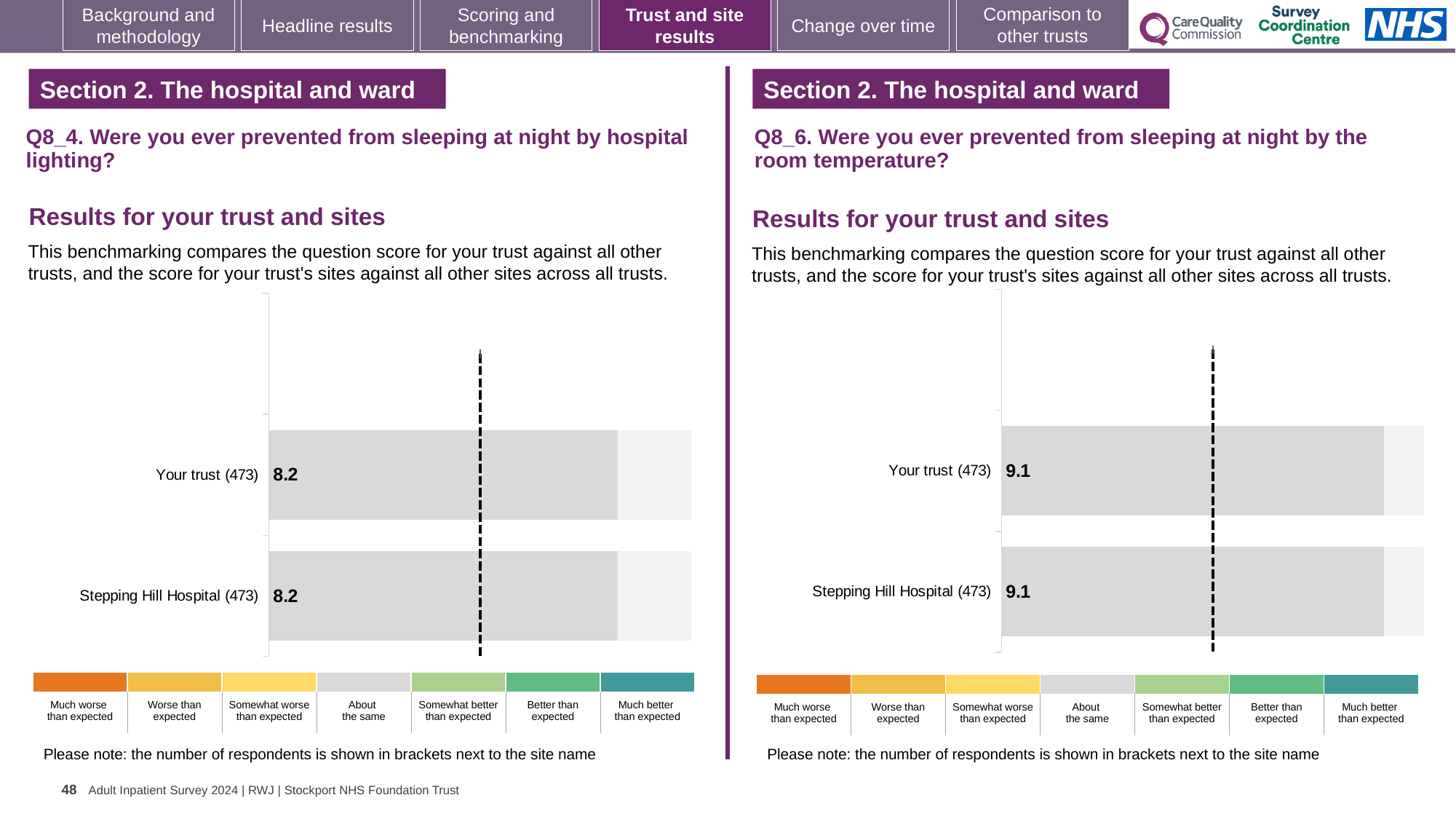
How many bars are plotted on the Q8_6 room temperature chart? 2 How many categories does the colour legend below the Q8_6 room temperature chart list? 7 On the Q8_6 room temperature chart, what is the score for Stepping Hill Hospital (473)? 9.1 On the Q8_6 room temperature chart, what is the difference between the Your trust score and the Stepping Hill Hospital score? 0.0 On the Q8_4 hospital lighting chart, what is the difference between the Your trust score and the Stepping Hill Hospital score? 0.0 On the Q8_4 hospital lighting chart, what is the score for Your trust (473)? 8.2 How many bars are plotted on the Q8_4 hospital lighting chart? 2 On the Q8_4 hospital lighting chart, what is the score for Stepping Hill Hospital (473)? 8.2 How many respondents are shown in brackets for Stepping Hill Hospital on the Q8_6 room temperature chart? 473 On the Q8_6 room temperature chart, what is the score for Your trust (473)? 9.1 What kind of chart is used on the Q8_4 hospital lighting chart? Bar chart On the Q8_4 hospital lighting chart, which benchmark category does the grey colour of the Your trust bar correspond to in the legend? About the same